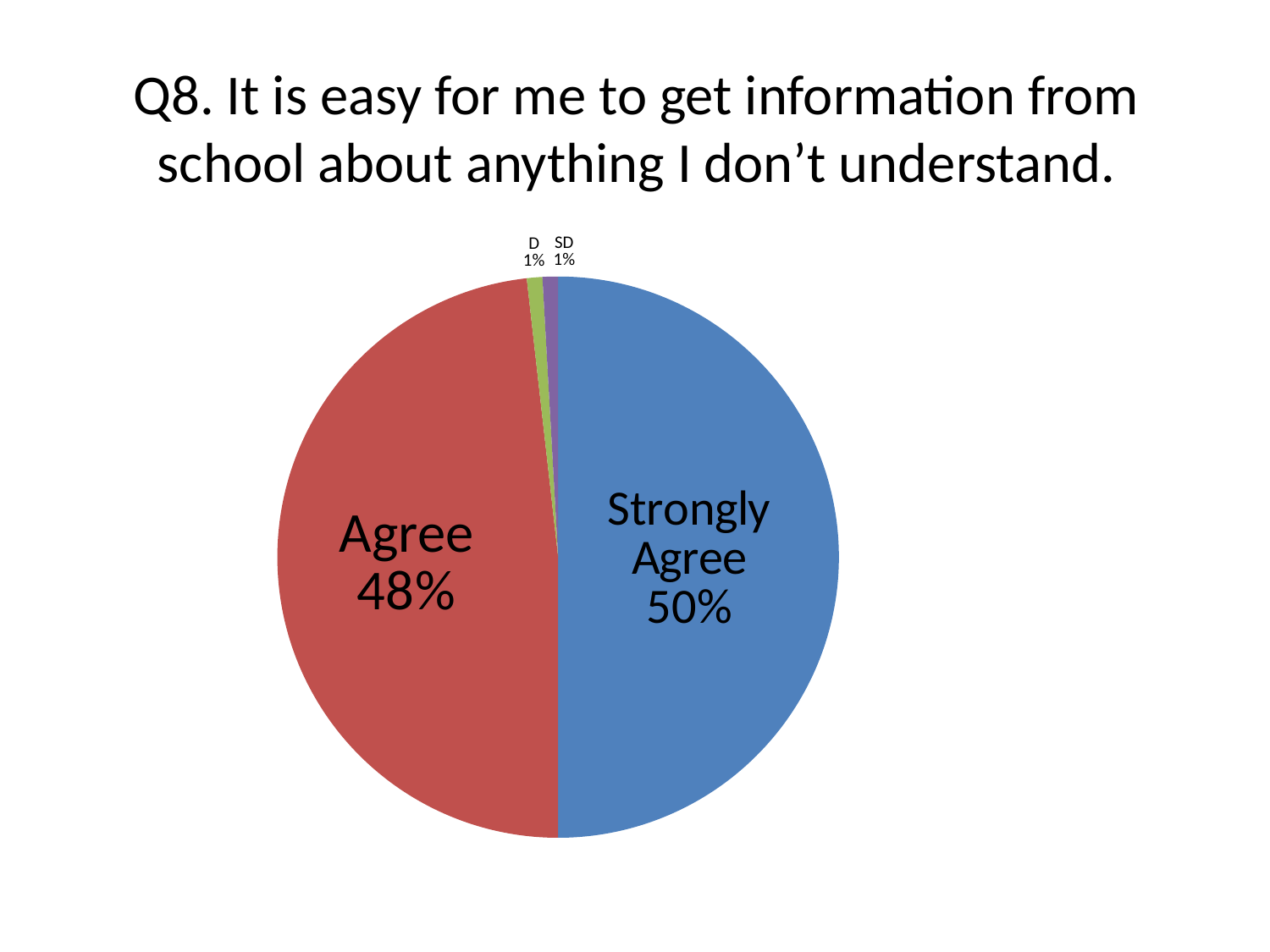
What colour is the Agree slice? red What share of the pie is labelled Strongly Agree? 50% What percentage is shown for the D slice? 1% What kind of chart is shown on the slide? pie chart How many slices does the pie chart have? 4 What percentage is shown for the SD slice? 1% Which slice of the pie is the largest? Strongly Agree What is the difference in percentage points between the Strongly Agree and Agree slices? 2% What is the combined percentage of the Strongly Agree and Agree slices? 98% What is the title of the chart? Q8. It is easy for me to get information from school about anything I don't understand. Which is larger, the Agree slice or the D slice? Agree What share of the pie is labelled Agree? 48%